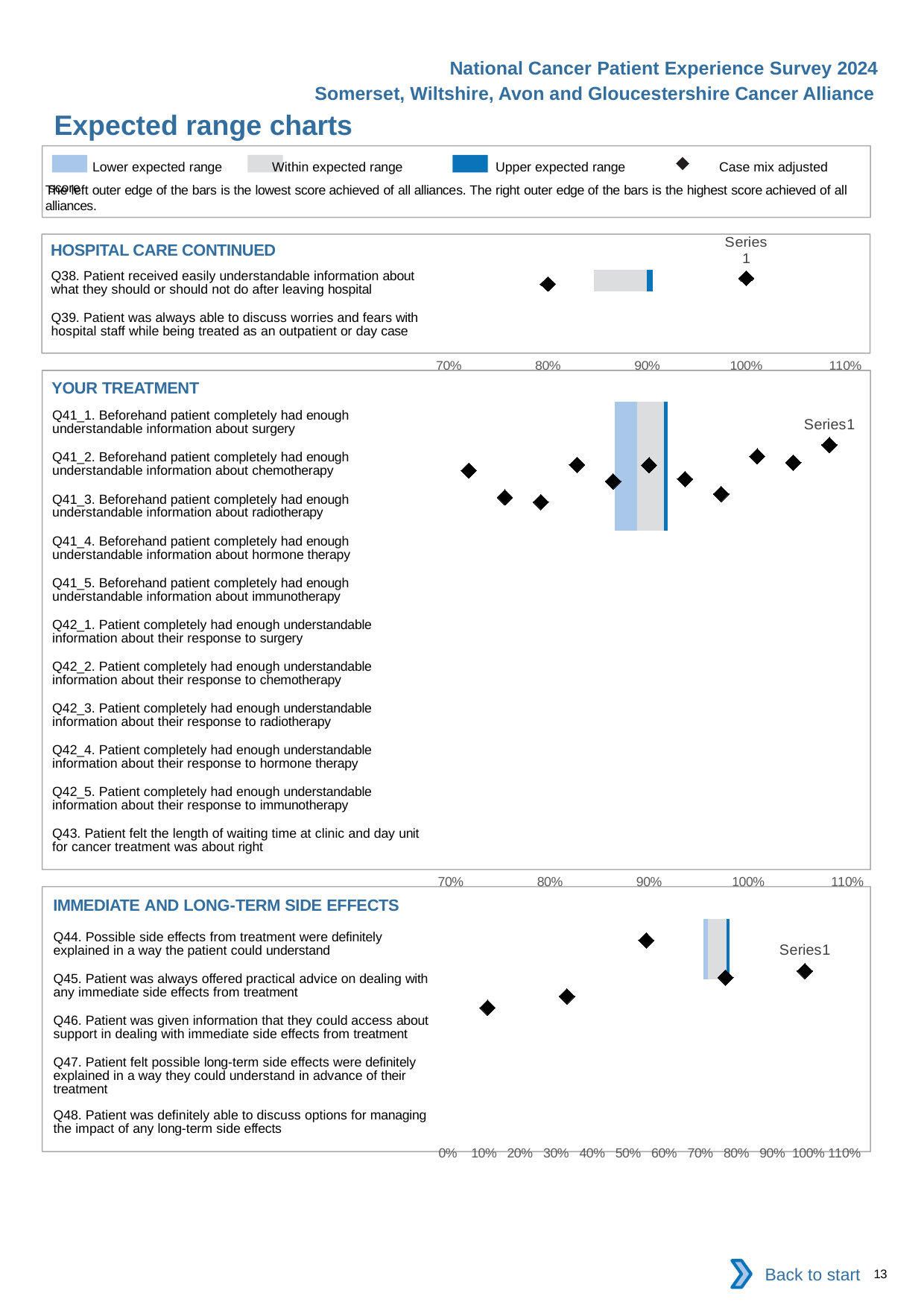
In the 'HOSPITAL CARE CONTINUED' chart, is the diamond plotted to the left of the shaded bar greater or less than 90%? less What is the lowest tick label on the x axis of the 'IMMEDIATE AND LONG-TERM SIDE EFFECTS' chart? 0% In the 'IMMEDIATE AND LONG-TERM SIDE EFFECTS' chart, is the leftmost plotted diamond greater or less than 20%? less How many separate charts are shown on the slide? 3 What series name appears in the legend of the 'YOUR TREATMENT' chart? Series1 What is the lowest tick label on the x axis of the 'HOSPITAL CARE CONTINUED' chart? 70% What kind of chart is used in the 'YOUR TREATMENT' section? bar chart In the 'YOUR TREATMENT' chart, how many diamond data points are plotted (excluding the legend marker)? 10 In the 'YOUR TREATMENT' chart, is the leftmost plotted diamond greater or less than 80%? less What is the highest tick label on the x axis of the 'YOUR TREATMENT' chart? 110%